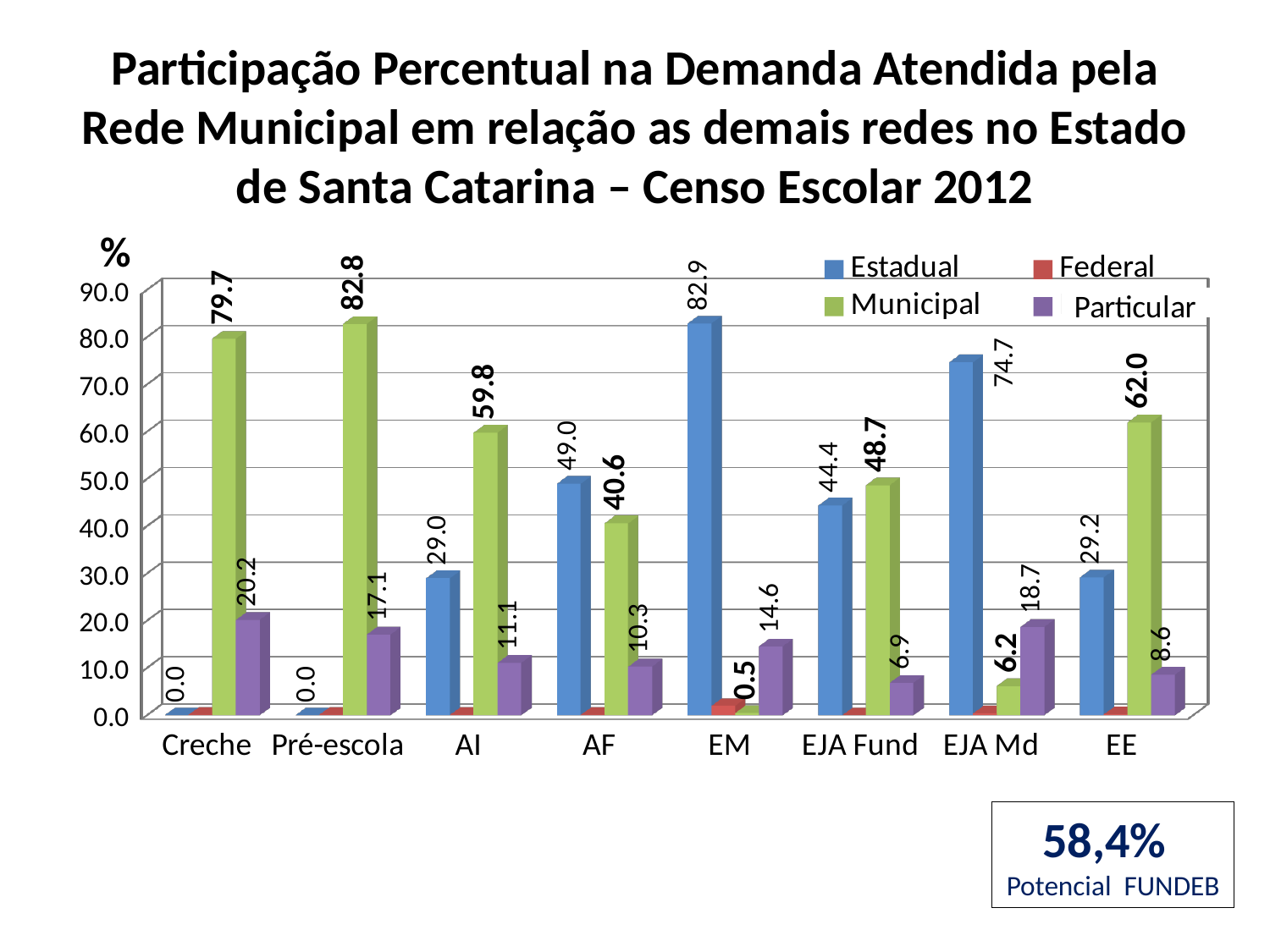
Is the Federal value for EM greater or less than 10? less For AF, what is the difference between the Estadual value and the Municipal value? 8.4 What kind of chart is shown on the slide? bar chart For EJA Fund, which is larger: the Estadual value or the Municipal value? Municipal What is the Estadual value for EM? 82.9 Which category has the lowest Particular value? EJA Fund How many series does the legend list? 4 What is the Municipal value for Pré-escola? 82.8 What is the Particular value for Creche? 20.2 Which category has the highest Municipal value? Pré-escola How many categories are shown on the x axis? 8 What colour represents the Municipal series in the legend? green